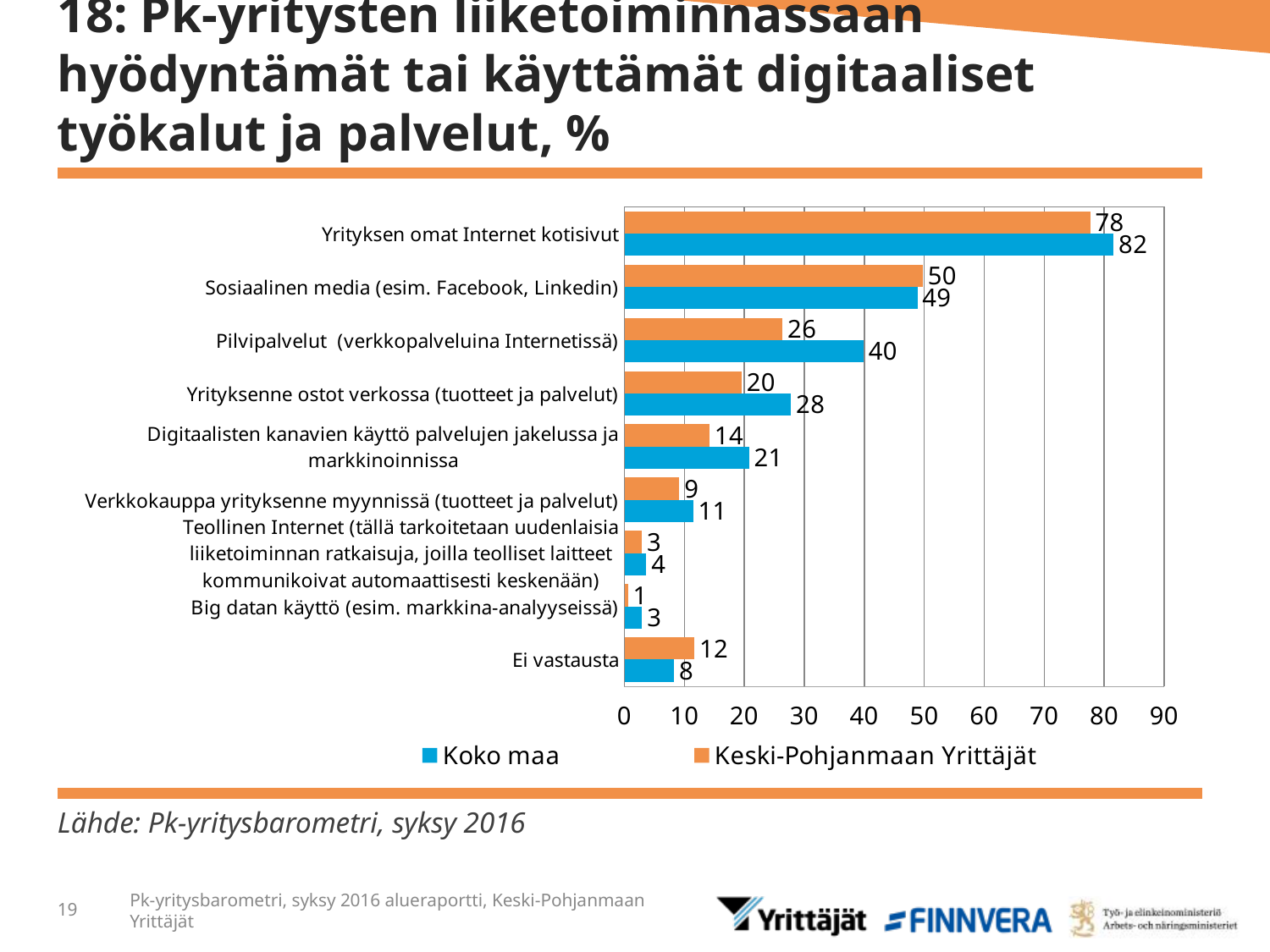
Which category has the lowest value for Keski-Pohjanmaan Yrittäjät? Big datan käyttö (esim. markkina-analyyseissä) What is the difference between the Koko maa and Keski-Pohjanmaan Yrittäjät values for Pilvipalvelut (verkkopalveluina Internetissä)? 14 For Ei vastausta, which series has the larger value, Koko maa or Keski-Pohjanmaan Yrittäjät? Keski-Pohjanmaan Yrittäjät What is the value for Koko maa for Yrityksenne ostot verkossa (tuotteet ja palvelut)? 28 Which category has the highest value for Keski-Pohjanmaan Yrittäjät? Yrityksen omat Internet kotisivut What kind of chart is shown on the slide? Bar chart What is the value for Koko maa for Yrityksen omat Internet kotisivut? 82 What is the value for Keski-Pohjanmaan Yrittäjät for Ei vastausta? 12 How many categories are shown on the chart? 9 Which colour represents the Koko maa series? Blue What is the value for Keski-Pohjanmaan Yrittäjät for Pilvipalvelut (verkkopalveluina Internetissä)? 26 How many series does the legend list? 2